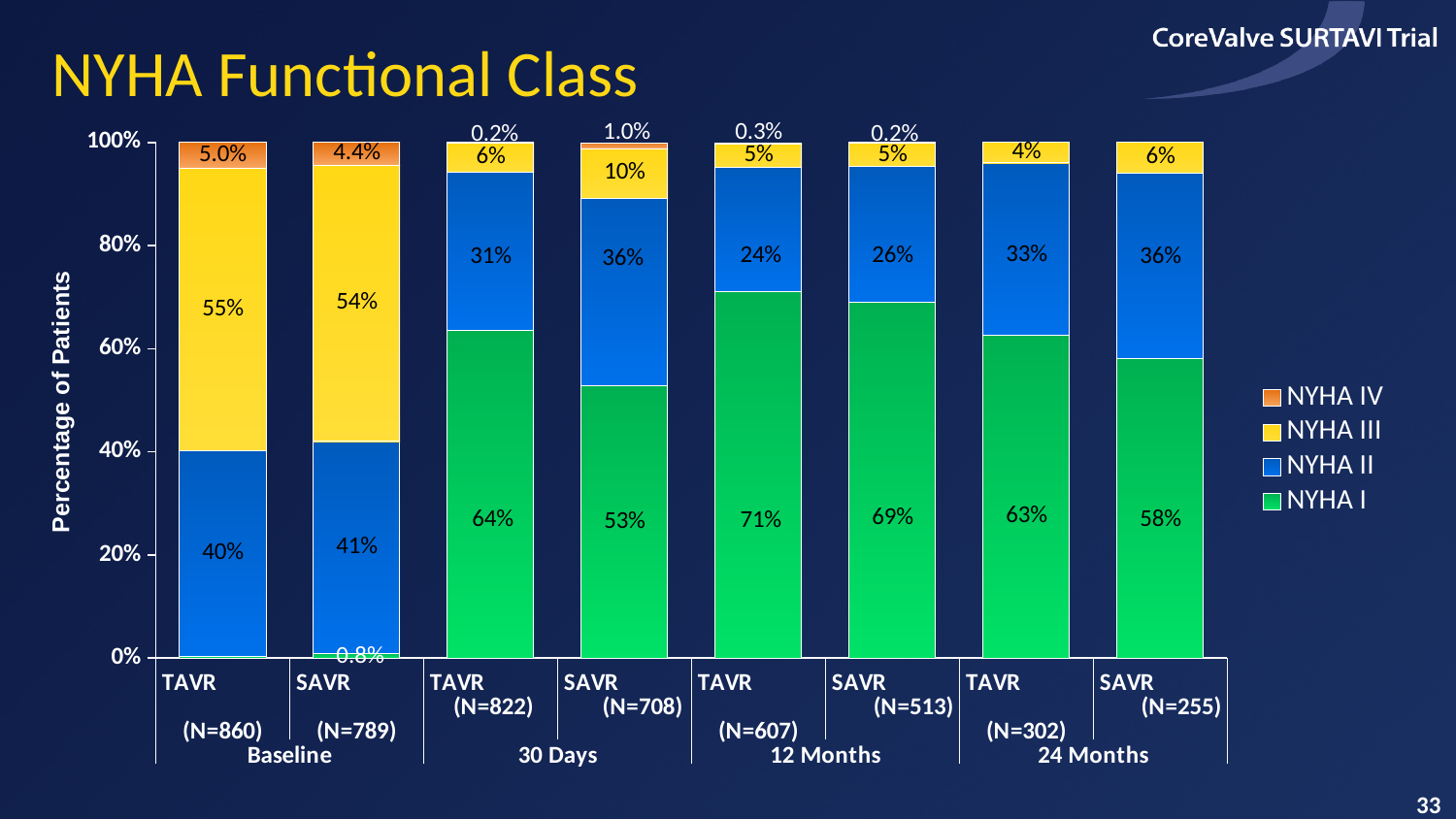
Which colour represents NYHA I in the legend? Green What kind of chart is shown on the slide? Stacked bar chart What is the NYHA III percentage for SAVR at Baseline? 54% How many bars are plotted in the chart? 8 What is the NYHA II percentage for SAVR at 24 Months? 36% Which bar has the highest NYHA I percentage? TAVR at 12 Months What is the NYHA I percentage for TAVR at 12 Months? 71% What is the difference between the NYHA I percentages for TAVR and SAVR at 30 Days? 11% What is the NYHA IV percentage for TAVR at Baseline? 5.0% How many series does the legend list? 4 What is the NYHA I percentage for SAVR at Baseline? 0.8% Which is larger, the NYHA II percentage for TAVR at 24 Months or for SAVR at 24 Months? SAVR at 24 Months